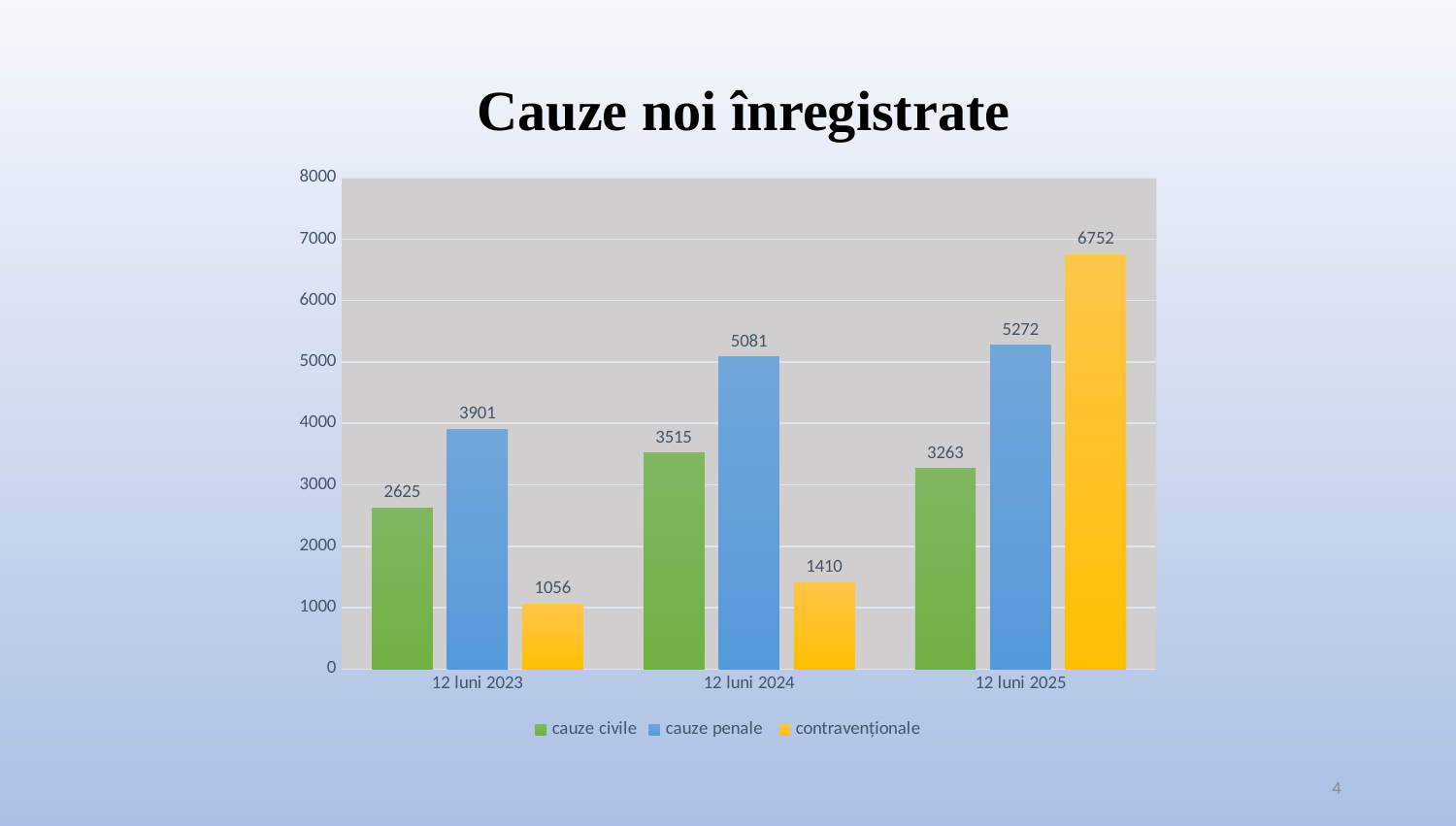
How many categories are shown on the x axis? 3 What is the value for cauze civile in 12 luni 2025? 3263 Is the value for contravenționale in 12 luni 2025 greater or less than 6000? greater What is the value for cauze penale in 12 luni 2024? 5081 What is the value for contravenționale in 12 luni 2023? 1056 What kind of chart is shown on the slide? bar chart Which series has the highest value in 12 luni 2025? contravenționale What is the difference between cauze penale in 12 luni 2025 and 12 luni 2024? 191 Which is larger: cauze civile in 12 luni 2024 or cauze civile in 12 luni 2025? cauze civile in 12 luni 2024 Which series has the lowest value in 12 luni 2023? contravenționale How many series does the legend list? 3 Do the values for contravenționale rise or fall from 12 luni 2023 to 12 luni 2025? rise